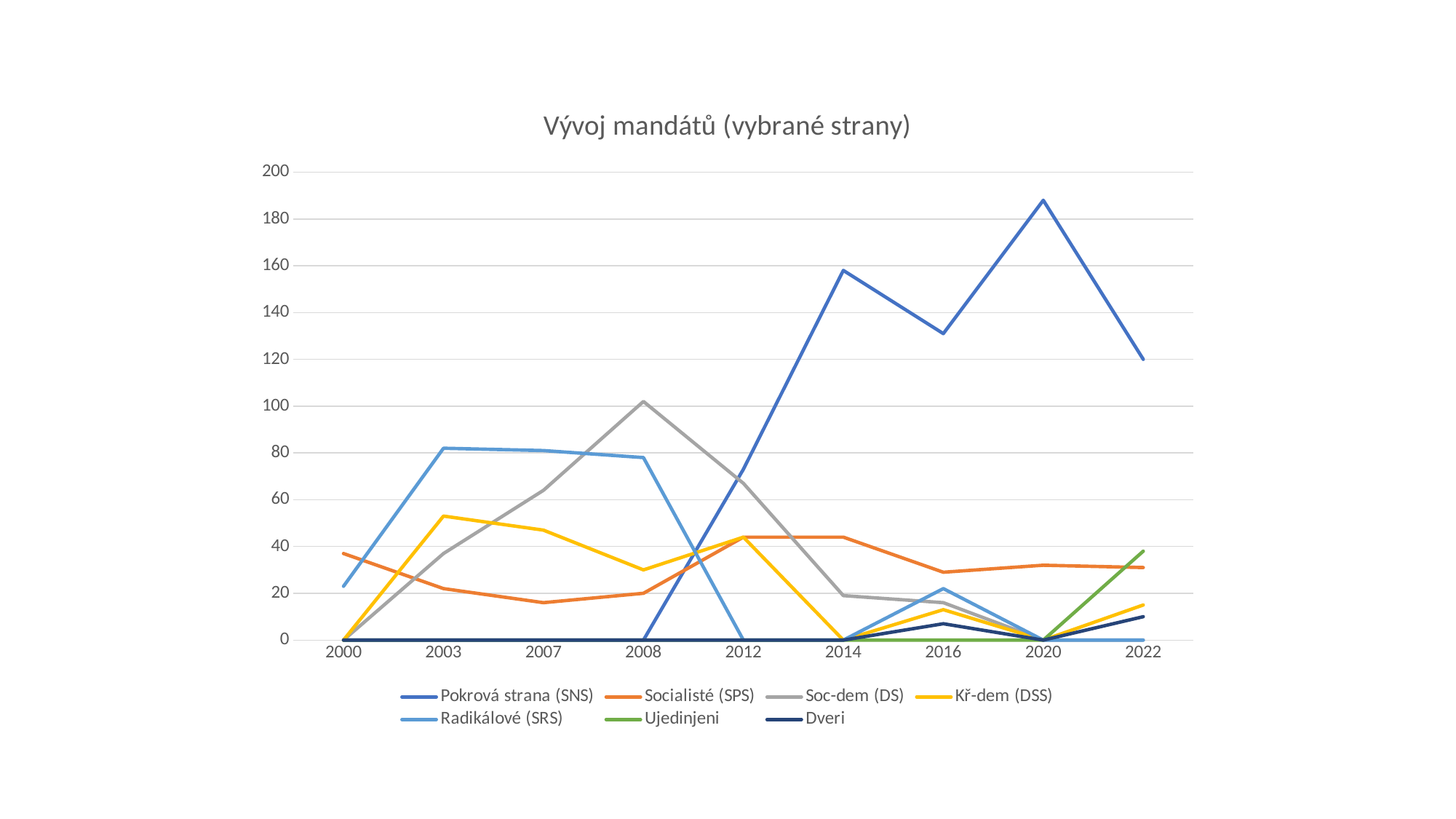
In 2012, which is larger: Socialisté (SPS) or Soc-dem (DS)? Soc-dem (DS) What type of chart is shown on the slide? line chart How many series does the legend list? 7 What is the title of the chart? Vývoj mandátů (vybrané strany) Is the value for Pokrová strana (SNS) in 2020 greater or less than 180? greater In which year does Pokrová strana (SNS) reach its highest value? 2020 Which series has the highest value in 2003? Radikálové (SRS) How many years are shown on the x axis? 9 What is the value for Pokrová strana (SNS) in 2008? 0 What is the value for Radikálové (SRS) in 2012? 0 Is the value for Soc-dem (DS) in 2008 greater or less than 80? greater Is the value for Radikálové (SRS) in 2003 greater or less than 60? greater